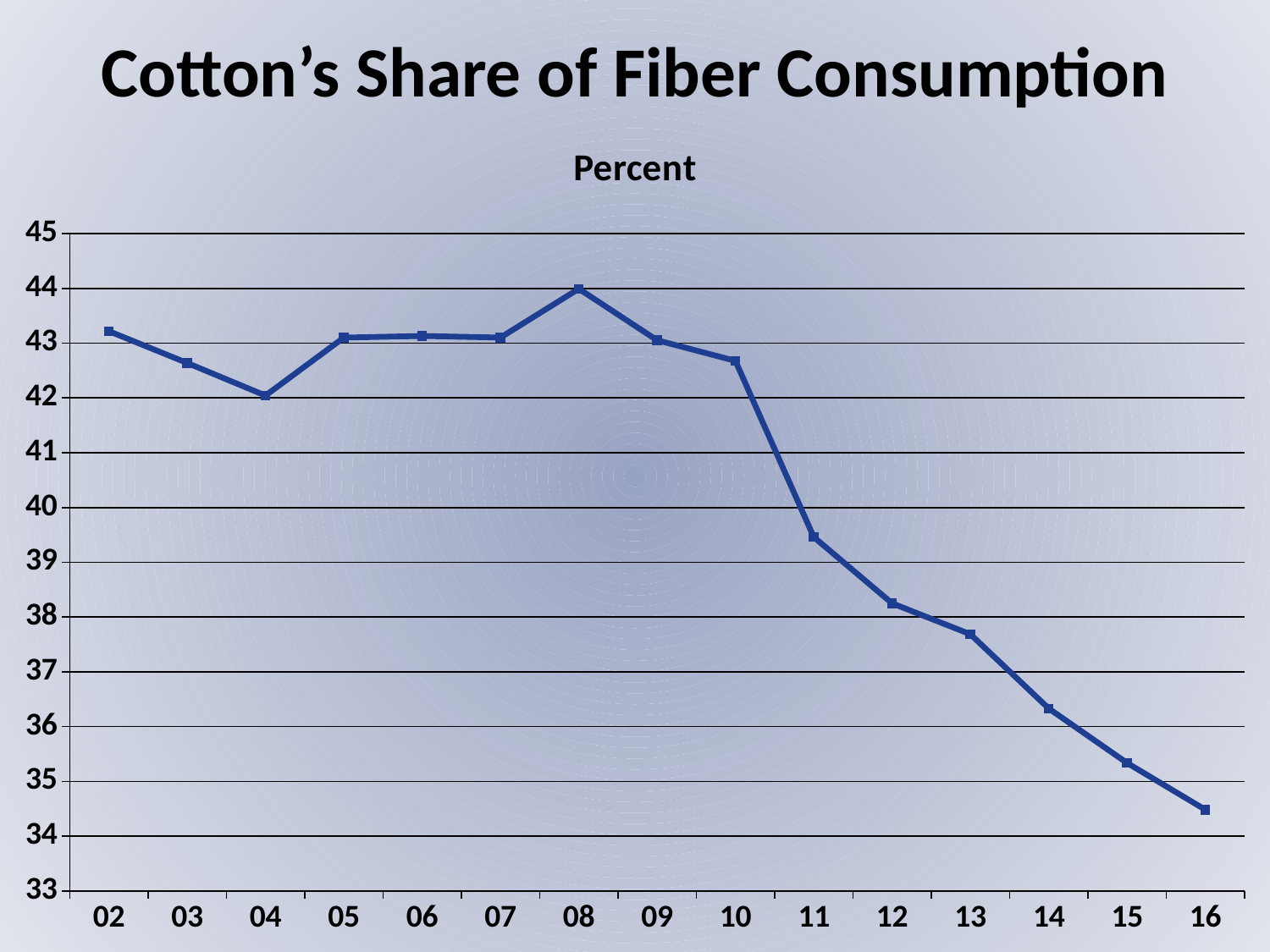
Is the value for 16 greater or less than 35? less What unit label is shown above the chart? Percent How many years are plotted on the x axis? 15 Which year has the larger value, 11 or 13? 11 Overall, does cotton's share of fiber consumption rise or fall from 02 to 16? fall Is the value for 11 greater or less than 40? less What is the title of the chart? Cotton's Share of Fiber Consumption What kind of chart is shown on the slide? line chart In which year is cotton's share of fiber consumption highest? 08 In which year is cotton's share of fiber consumption lowest? 16 Is the value for 10 greater or less than 42? greater Which year has the larger value, 02 or 16? 02